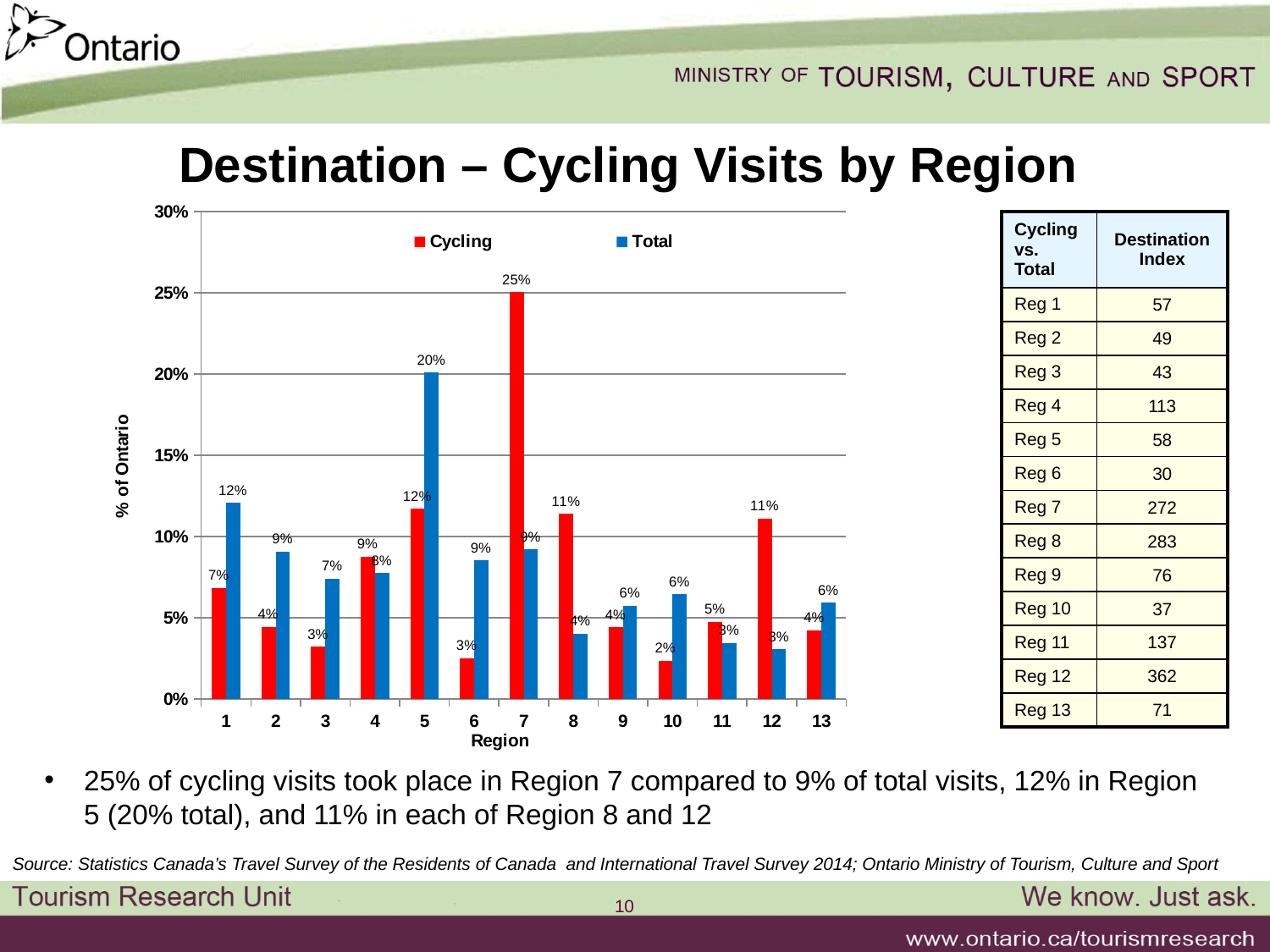
What is the Total value for Region 5? 20% What kind of chart is shown on the slide? Bar chart Which region has the lowest Cycling value? Region 10 What is the Cycling value for Region 12? 11% Which region has the highest Cycling value? Region 7 How many regions are shown on the x axis? 13 What is the Cycling value for Region 7? 25% What is the difference between the Cycling and Total values for Region 7? 16% How many series does the legend list? 2 Which region has the highest Total value? Region 5 What is the Total value for Region 1? 12% Which is larger for Region 5, the Cycling value or the Total value? Total